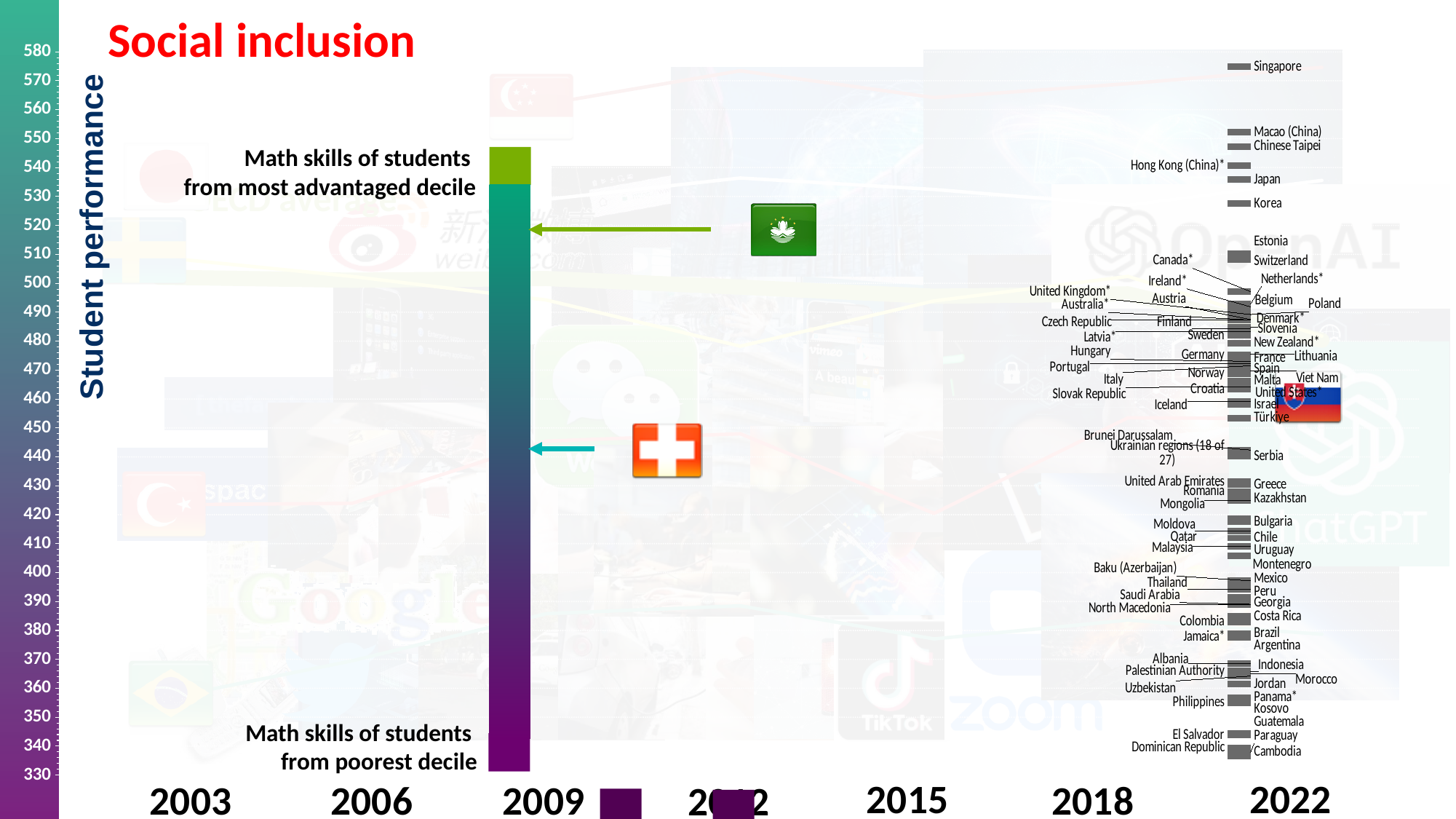
Is the 2022 value for Singapore greater or less than 570? greater In 2022, which has the higher student performance, Singapore or Macao (China)? Singapore What is the label on the vertical axis of the chart? Student performance Is the 2022 value for Cambodia greater or less than 340? less Is the 2022 value for Japan greater or less than 530? greater Which country has the lowest student performance in 2022? Cambodia Which country has the highest student performance in 2022? Singapore In 2022, which has the higher student performance, Japan or Korea? Japan How many years are labelled along the horizontal axis? 7